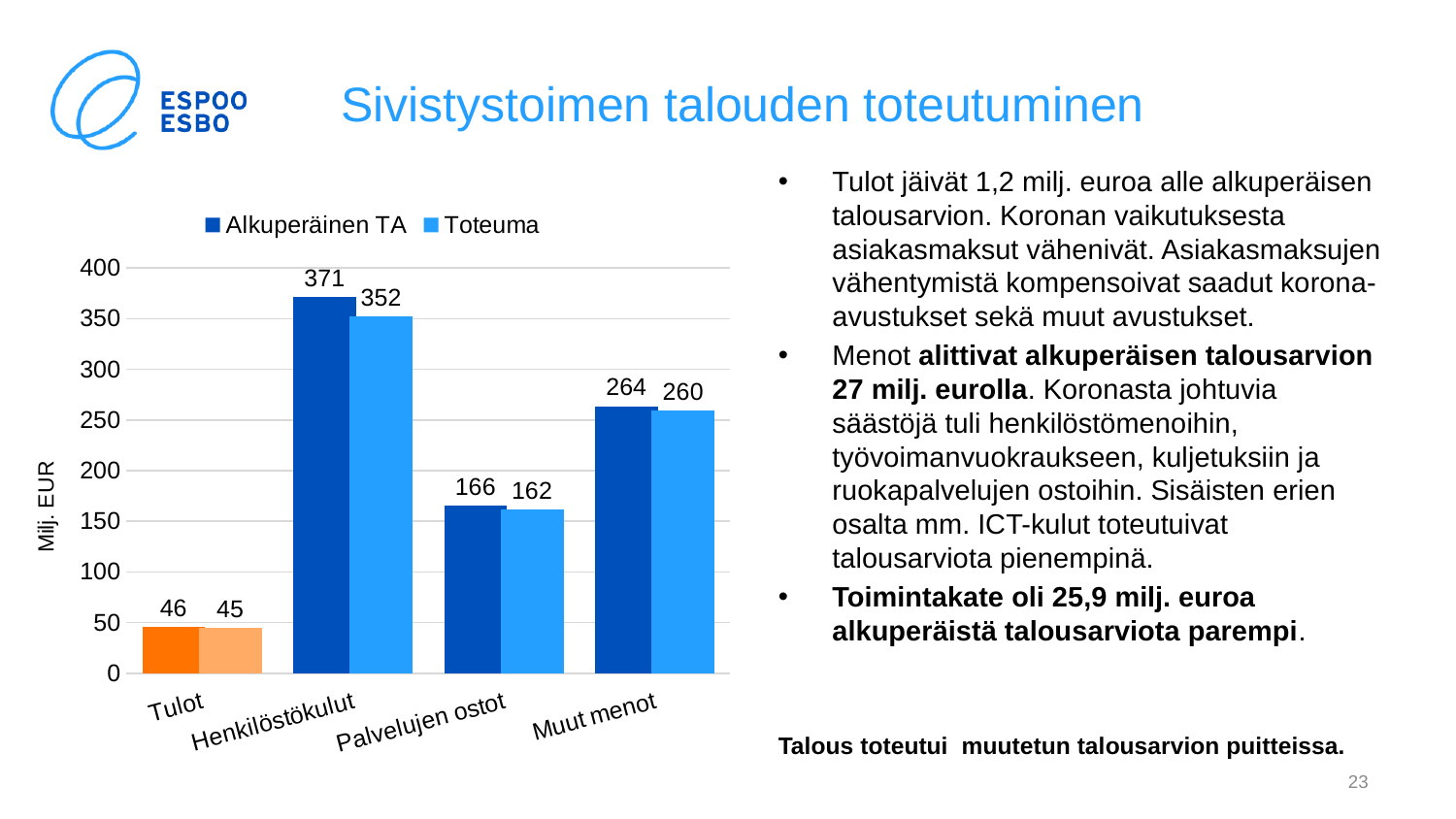
Which is larger for Muut menot: Alkuperäinen TA or Toteuma? Alkuperäinen TA Which category has the lowest Toteuma value? Tulot What is the Alkuperäinen TA value for Henkilöstökulut? 371 How many categories are shown on the x axis? 4 What is the difference between the Alkuperäinen TA and Toteuma values for Henkilöstökulut? 19 What is the label of the y axis? Milj. EUR What is the Toteuma value for Tulot? 45 What is the Toteuma value for Palvelujen ostot? 162 What is the Alkuperäinen TA value for Muut menot? 264 What kind of chart is shown on the slide? Bar chart Which category has the highest Alkuperäinen TA value? Henkilöstökulut How many series does the legend list? 2